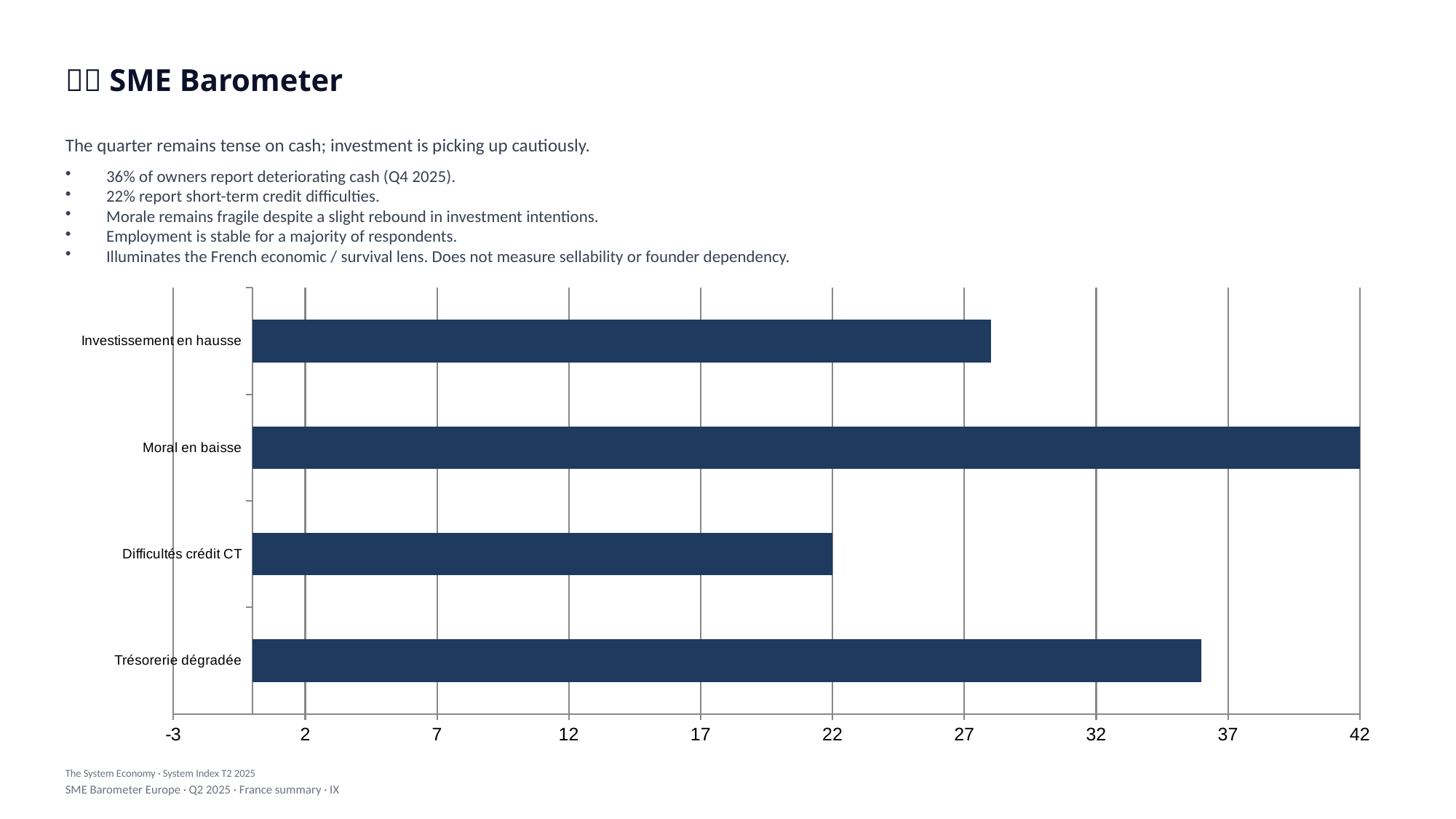
Is the value for Trésorerie dégradée greater or less than 32? greater Which is larger, the value for Trésorerie dégradée or the value for Investissement en hausse? Trésorerie dégradée Which category has the lowest value in the chart? Difficultés crédit CT Is the value for Investissement en hausse greater or less than 32? less What kind of chart is shown on the slide? bar chart What is the difference between the values for Moral en baisse and Difficultés crédit CT? 20 Which is larger, the value for Moral en baisse or the value for Difficultés crédit CT? Moral en baisse What is the value for Moral en baisse? 42 How many categories are plotted in the chart? 4 What is the leftmost tick label on the horizontal axis of the chart? -3 What is the value for Difficultés crédit CT? 22 Which category has the highest value in the chart? Moral en baisse